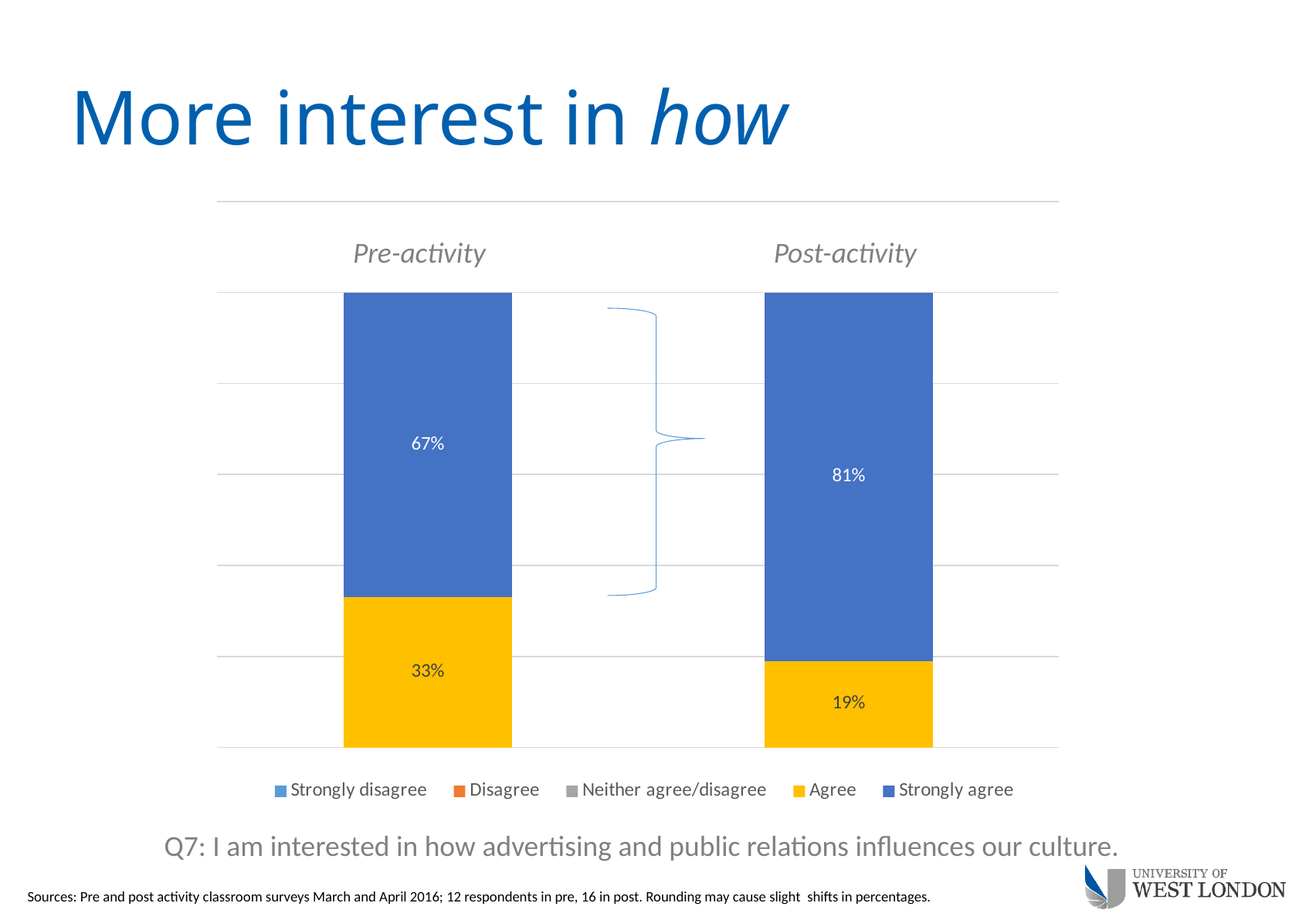
How many series does the legend list? 5 By how many percentage points did the Agree share change from Pre-activity to Post-activity? 14 percentage points What percentage of Post-activity respondents answered Agree? 19% By how many percentage points did the Strongly agree share change from Pre-activity to Post-activity? 14 percentage points What is the total of the Pre-activity stacked bar? 100% Which bar has the larger Agree share, Pre-activity or Post-activity? Pre-activity What percentage of Pre-activity respondents answered Strongly agree? 67% What percentage of Pre-activity respondents answered Agree? 33% What percentage of Post-activity respondents answered Strongly agree? 81% Which bar has the larger Strongly agree share, Pre-activity or Post-activity? Post-activity How many bars are plotted on the chart? 2 What kind of chart is shown on the slide? Stacked bar chart